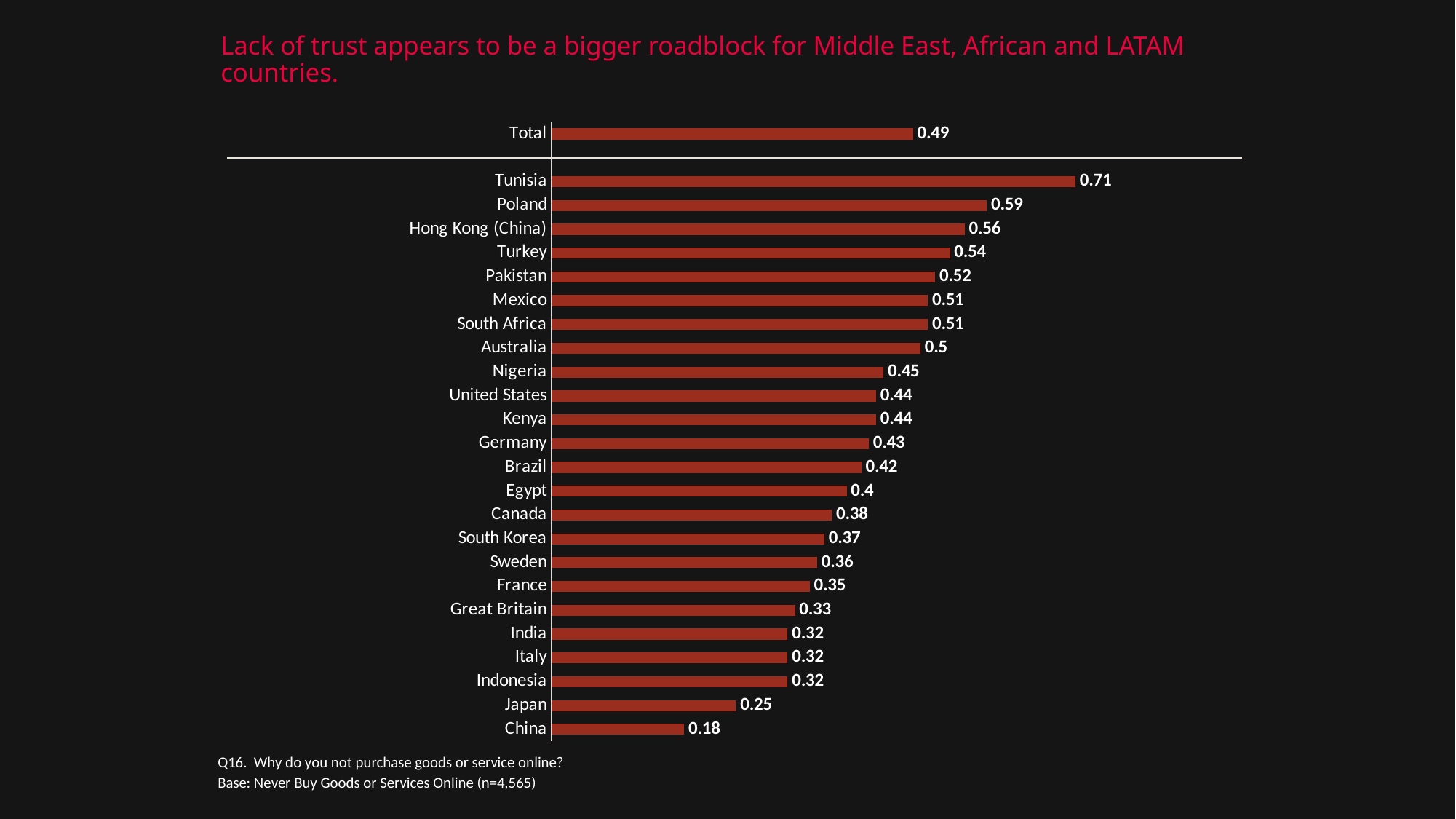
Which country has the lowest value? China What is the value for Japan? 0.25 What is the value for the Total bar? 0.49 Which country has the highest value? Tunisia What is the value for Hong Kong (China)? 0.56 Which has a larger value, Pakistan or Nigeria? Pakistan What kind of chart is shown on the slide? Bar chart Which has a larger value, Egypt or Canada? Egypt How many countries are listed below the Total bar? 24 What is the value for Tunisia? 0.71 What is the difference between the values for Poland and Germany? 0.16 What is the difference between the values for Tunisia and China? 0.53